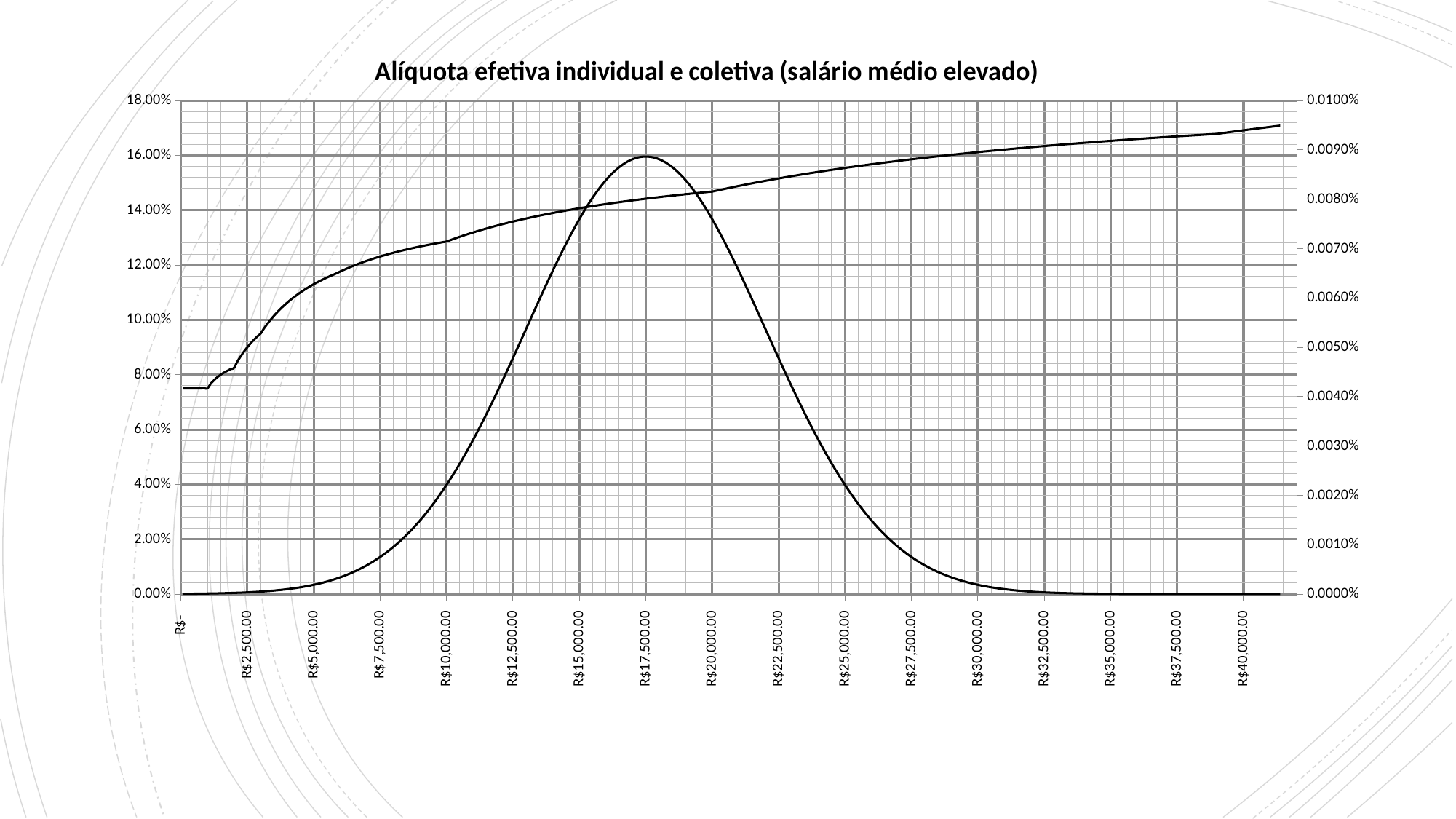
Does the steadily rising line increase or decrease as the x axis moves from R$- to R$40,000.00? increase On the right axis, is the value of the bell-shaped line at R$35,000.00 greater or less than 0.0010%? less What is the title of the chart? Alíquota efetiva individual e coletiva (salário médio elevado) On the left axis, is the value of the rising line at R$40,000.00 greater or less than 16.00%? greater What kind of chart is shown on the slide? line chart On the left axis, is the value of the rising line at R$10,000.00 greater or less than 12.00%? greater How many labelled tick marks are there on the x axis? 17 What is the highest value shown on the left vertical axis? 18.00% How many lines are plotted on the chart? 2